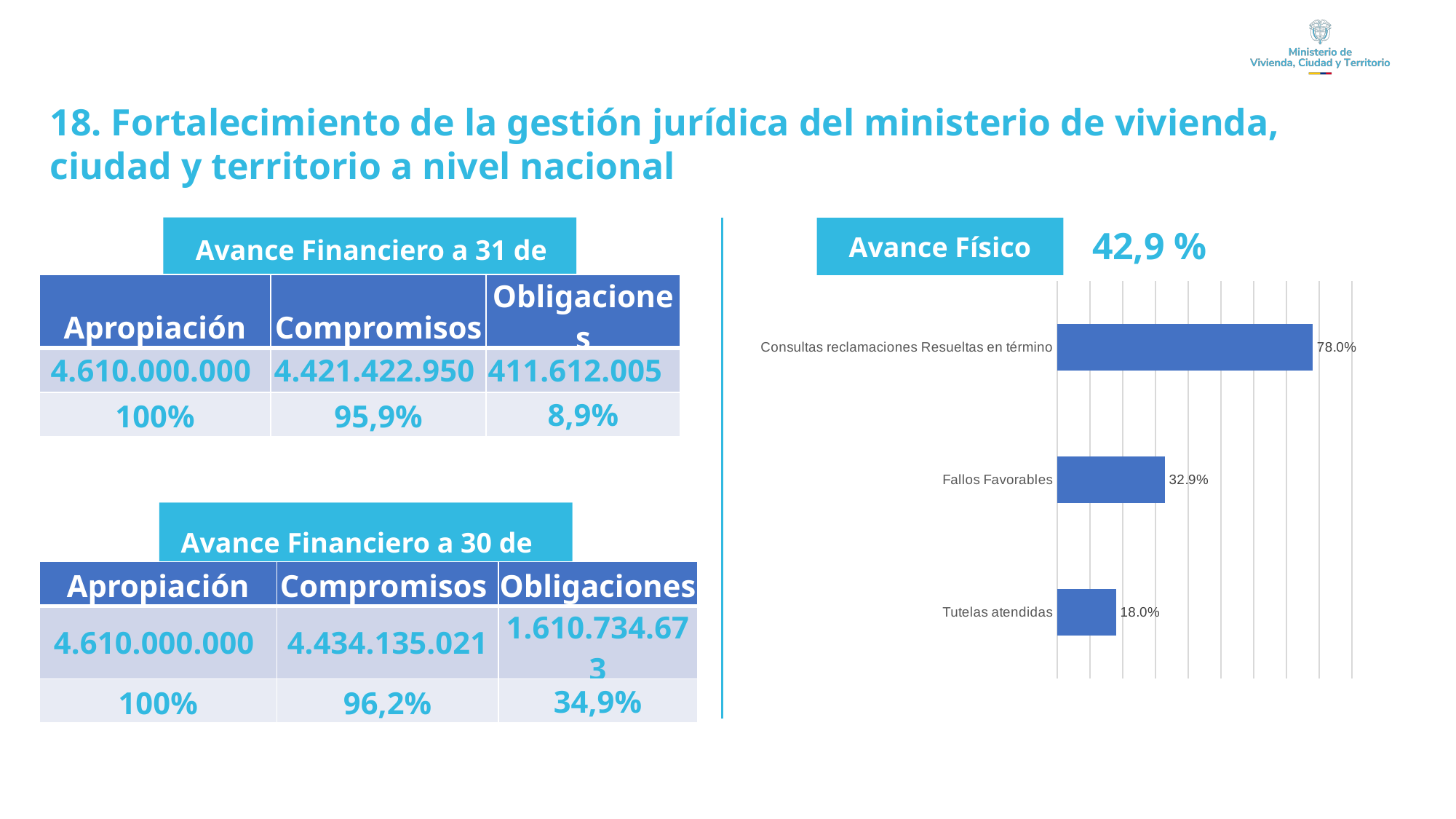
What is the difference between the values for Consultas reclamaciones Resueltas en término and Tutelas atendidas? 60.0% What is the difference between the values for Fallos Favorables and Tutelas atendidas? 14.9% What is the difference between the values for Consultas reclamaciones Resueltas en término and Fallos Favorables? 45.1% Which is larger, the value for Fallos Favorables or the value for Tutelas atendidas? Fallos Favorables How many categories are shown in the bar chart? 3 What is the value for Consultas reclamaciones Resueltas en término? 78.0% Which category has the lowest value in the bar chart? Tutelas atendidas What is the heading shown above the bar chart? Avance Físico What is the value for Tutelas atendidas? 18.0% What is the value for Fallos Favorables? 32.9% Which category has the highest value in the bar chart? Consultas reclamaciones Resueltas en término What kind of chart is shown on the right side of the slide? Bar chart